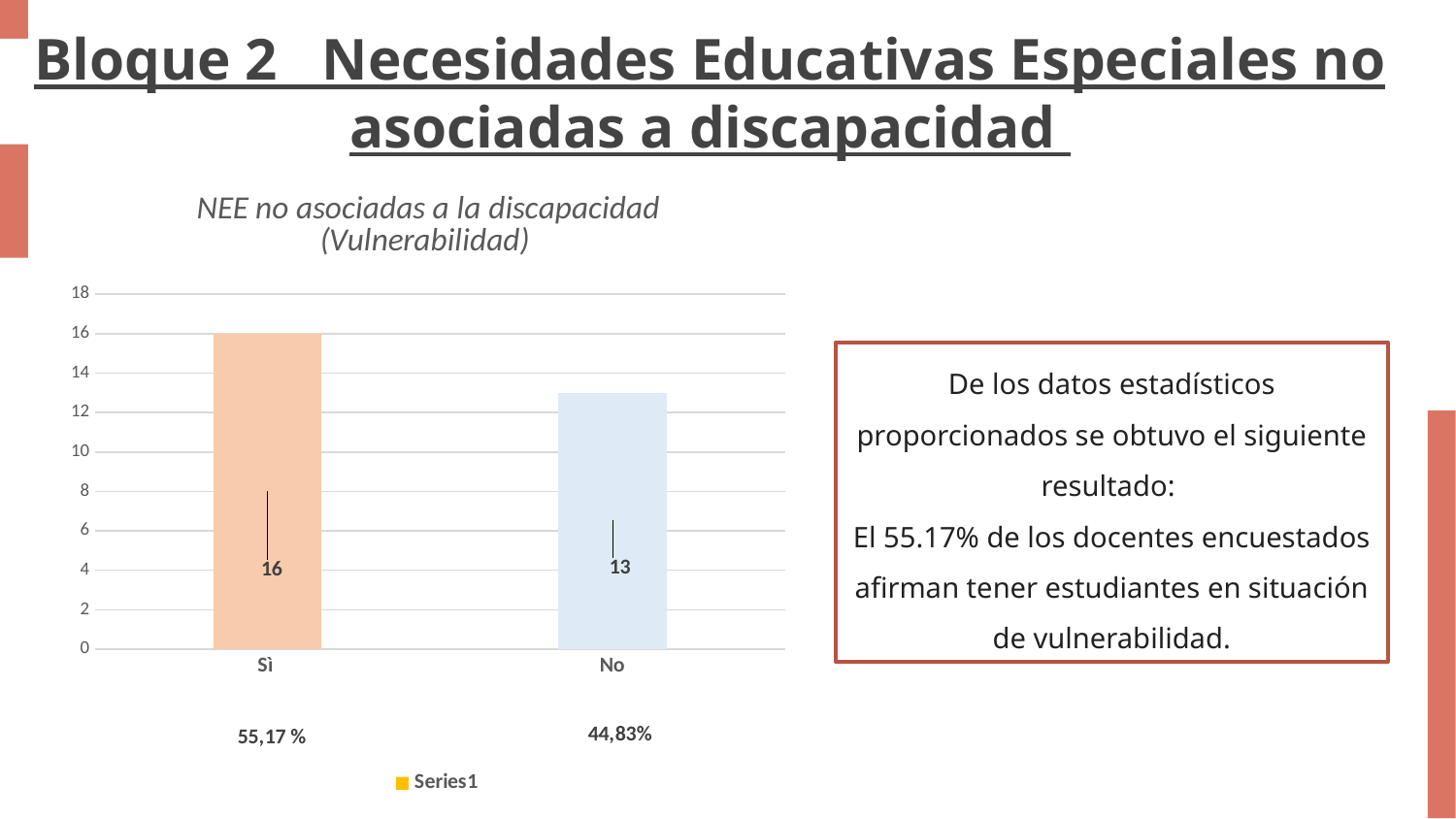
Which is larger, the value for "Sì" or the value for "No"? Sì What kind of chart is shown on the slide? bar chart Which category has the highest value? Sì What is the value for "Sì" in the chart? 16 What is the difference between the values for "Sì" and "No"? 3 What is the title of the chart? NEE no asociadas a la discapacidad (Vulnerabilidad) What is the value for "No" in the chart? 13 Which category has the lowest value? No How many series does the legend list? 1 How many categories are shown in the chart? 2 Is the value for "No" greater or less than 14? less What percentage is printed below the "Sì" bar? 55,17 %